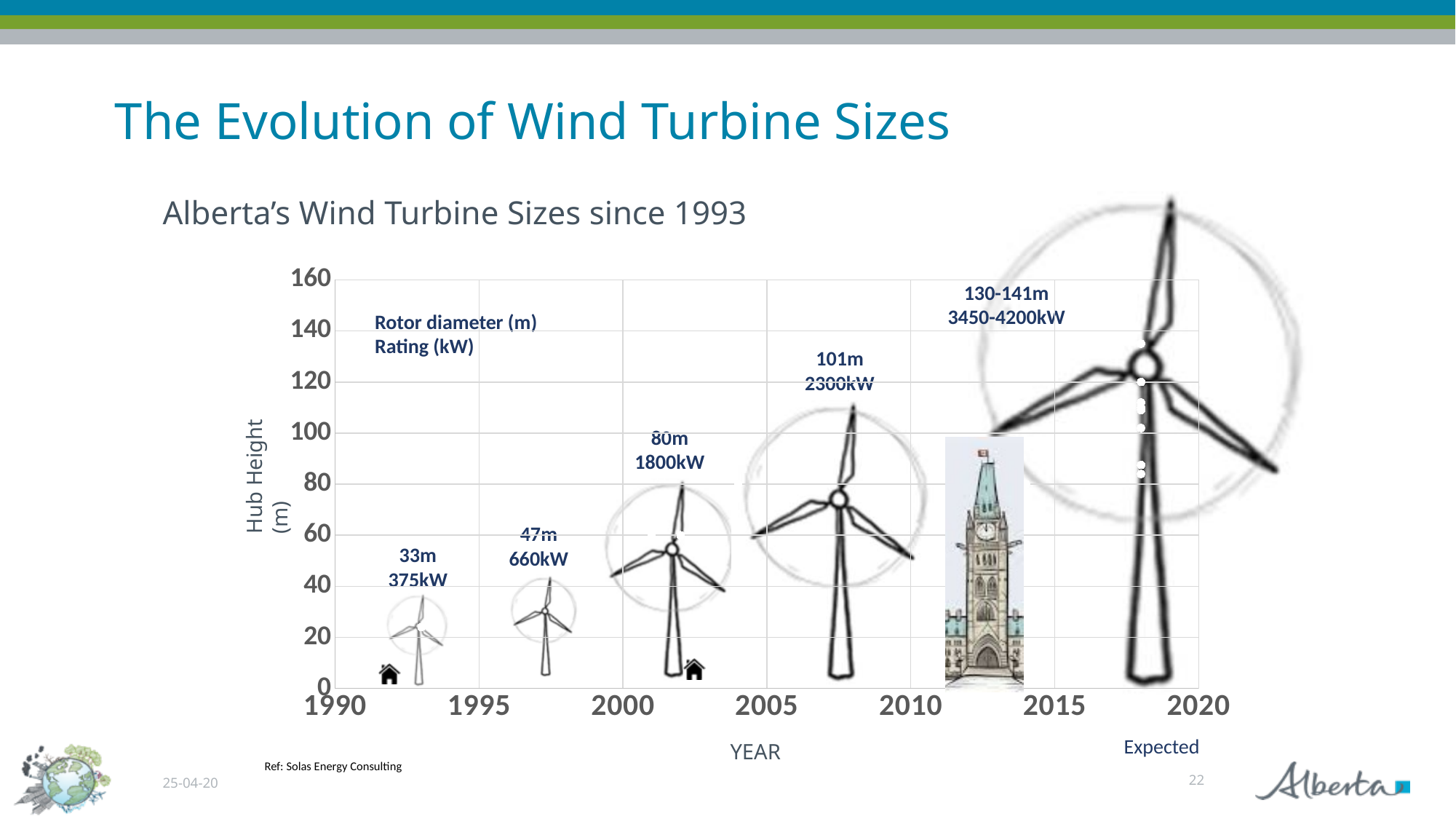
What is the label of the vertical axis of the chart? Hub Height (m) Do turbine hub heights rise or fall as the year increases along the x axis? rise What rotor diameter is labelled for the turbine installed around 1993? 33m How many turbines are plotted on the chart? 5 What is the title of the chart on the slide? Alberta's Wind Turbine Sizes since 1993 Which turbine has the smallest labelled rotor diameter? 33m (375kW) What rating is labelled for the turbine with an 80m rotor diameter? 1800kW What rating range is labelled for the expected turbine around 2018? 3450-4200kW What rating in kW is labelled for the turbine with a 47m rotor diameter? 660kW Is the hub height of the turbine around 1993 greater or less than 40 m? less What rotor diameter range is labelled for the expected turbine around 2018? 130-141m What rotor diameter is labelled for the turbine rated 2300kW? 101m